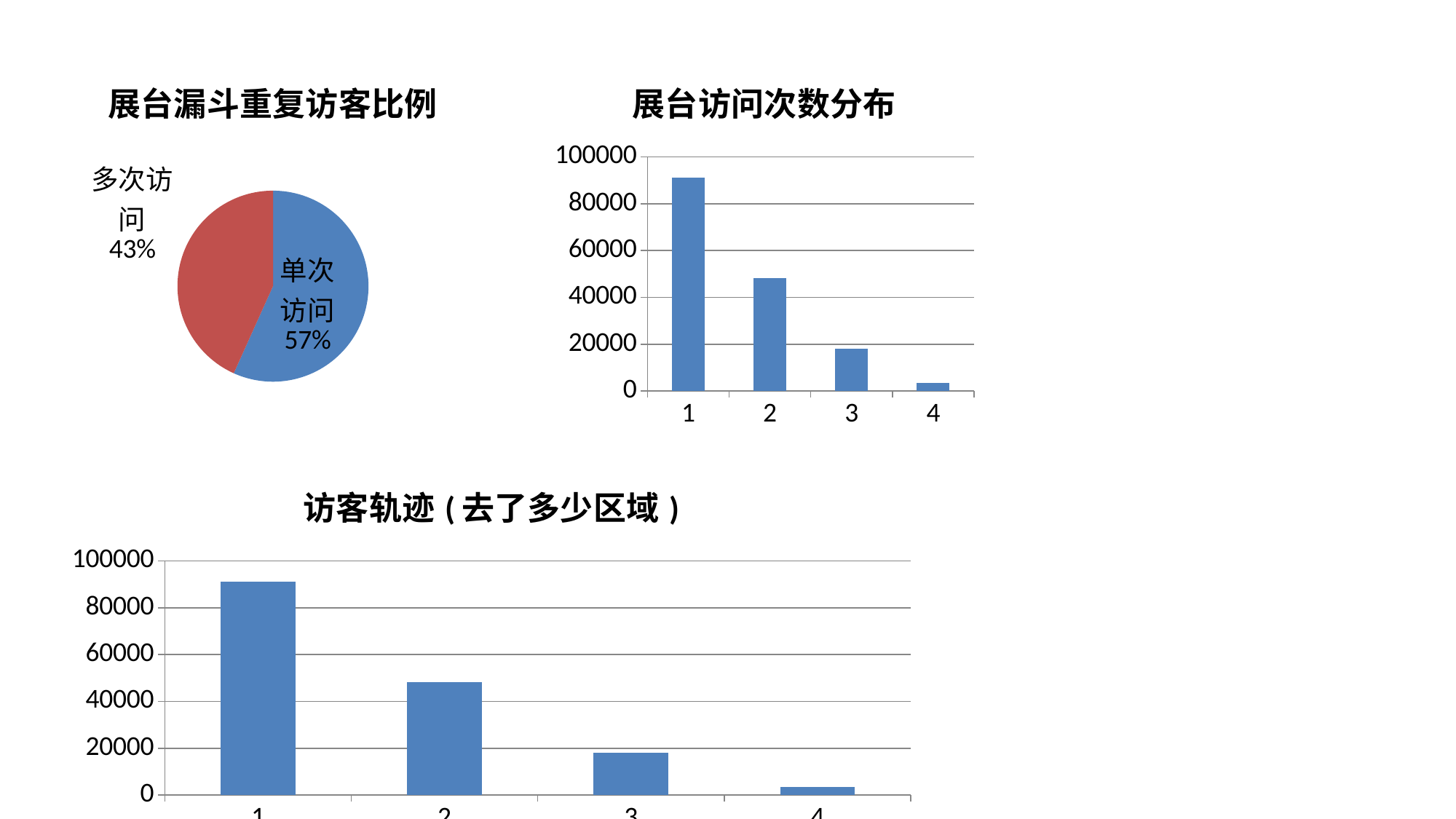
In the pie chart titled 展台漏斗重复访客比例, which slice is larger, 单次访问 or 多次访问? 单次访问 In the pie chart titled 展台漏斗重复访客比例, by how many percentage points does 单次访问 exceed 多次访问? 14 percentage points In the pie chart titled 展台漏斗重复访客比例, what percentage is shown for 多次访问? 43% In the chart titled 展台访问次数分布, which category has the lowest value? 4 In the chart titled 展台访问次数分布, do the values rise or fall from category 1 to category 4? fall In the chart titled 访客轨迹（去了多少区域）, is the value for category 2 greater or less than 40000? greater In the pie chart titled 展台漏斗重复访客比例, how many slices does the pie have? 2 In the pie chart titled 展台漏斗重复访客比例, what percentage is shown for 单次访问? 57% In the chart titled 展台访问次数分布, which category has the highest value? 1 In the chart titled 展台访问次数分布, is the value for category 1 greater or less than 80000? greater In the chart titled 访客轨迹（去了多少区域）, how many categories are shown on the x axis? 4 What kind of chart is the one titled 访客轨迹（去了多少区域）? bar chart